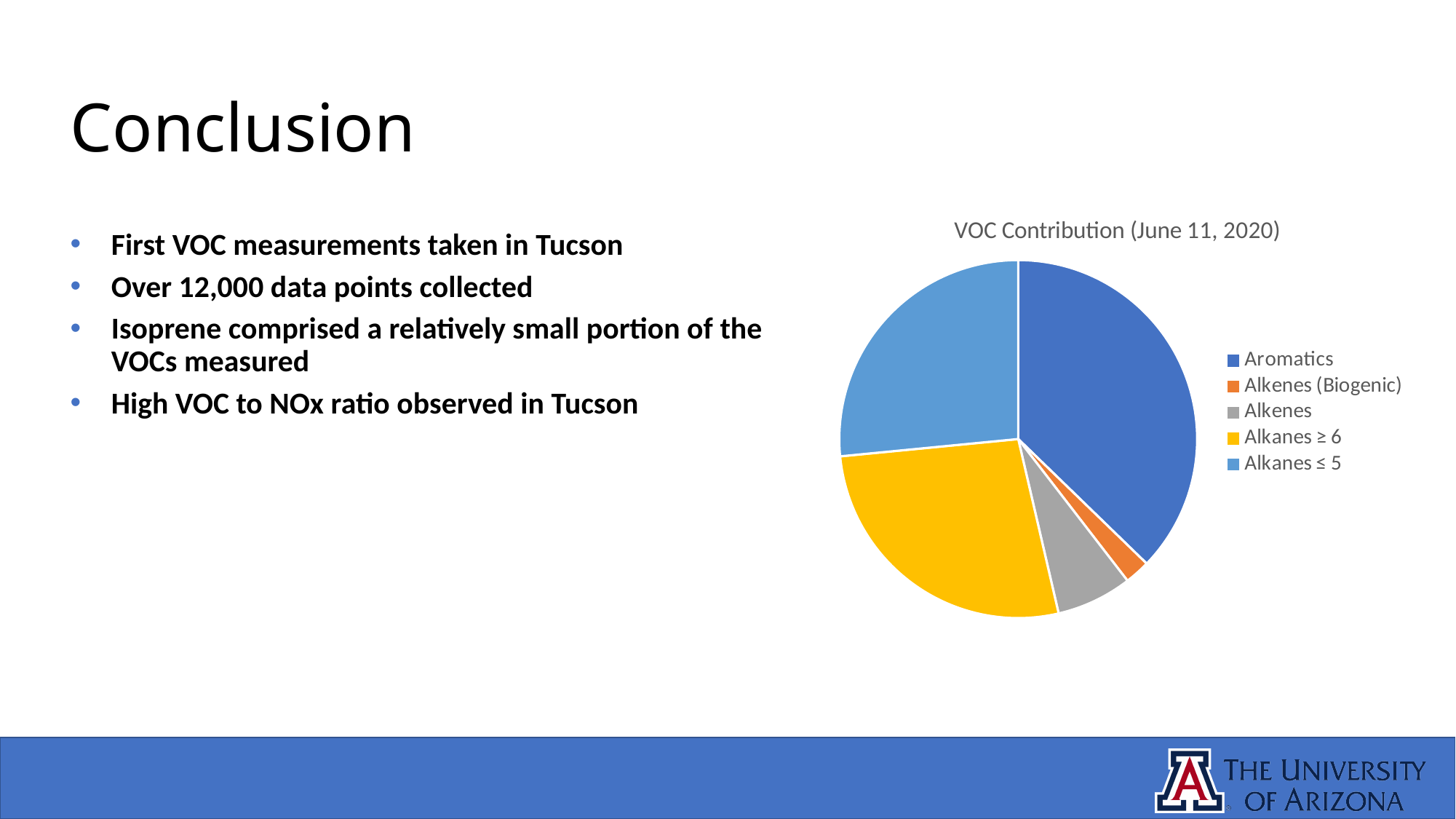
What is the title of the chart? VOC Contribution (June 11, 2020) How many entries does the legend list? 5 Which category is shown in yellow in the pie chart? Alkanes ≥ 6 Which slice is larger, Alkenes or Alkenes (Biogenic)? Alkenes Which slice is larger, Alkanes ≥ 6 or Alkenes? Alkanes ≥ 6 Which slice is larger, Aromatics or Alkanes ≤ 5? Aromatics What kind of chart is shown on the slide? pie chart Which category has the largest slice of the pie? Aromatics How many categories does the pie chart show? 5 Which category has the smallest slice of the pie? Alkenes (Biogenic)